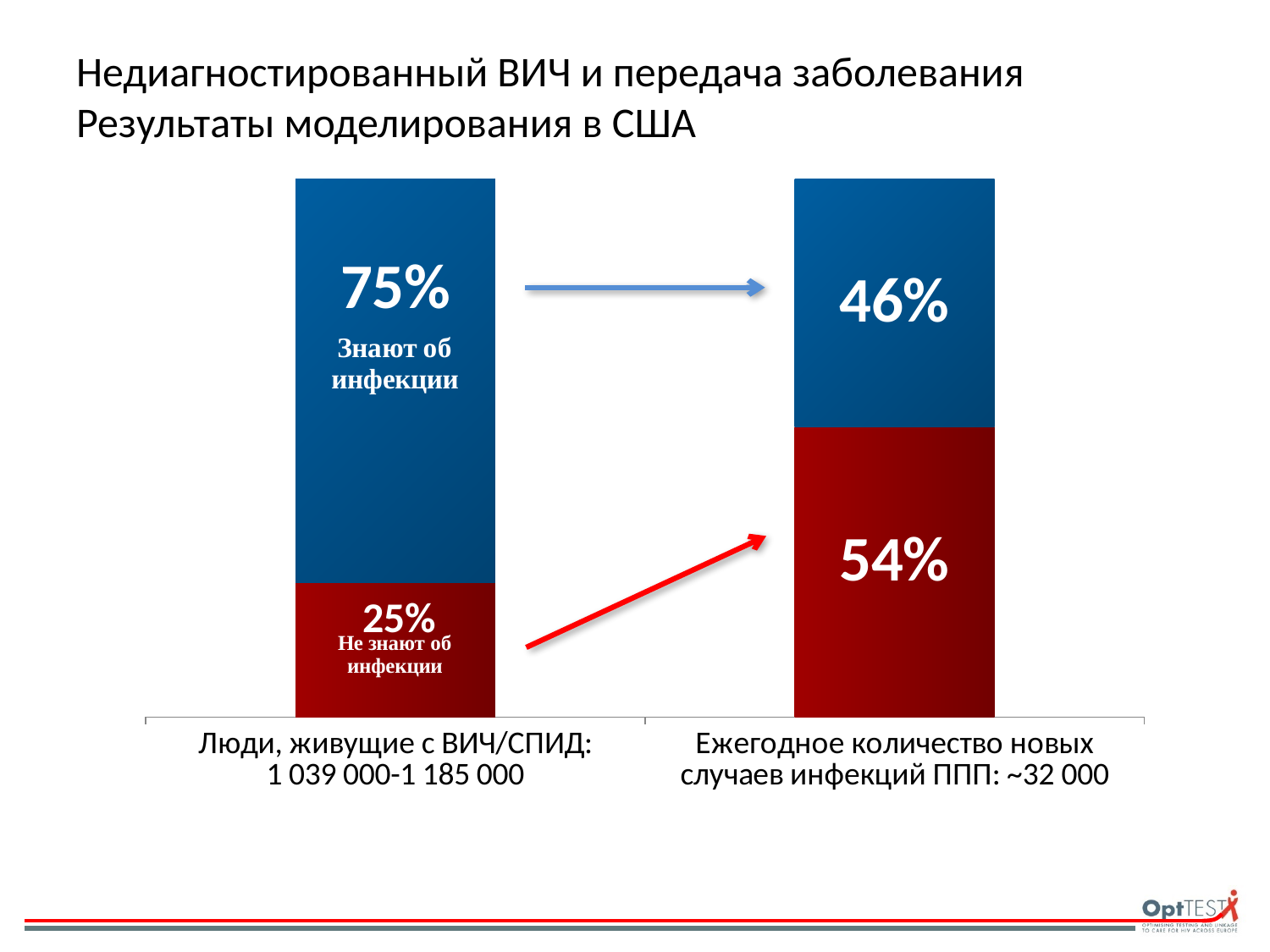
Which is larger: the red segment in the first bar or the red segment in the second bar? the red segment in the second bar (54%) What share of people living with HIV/AIDS (Люди, живущие с ВИЧ/СПИД) do not know about their infection (Не знают об инфекции)? 25% How many bars (categories) does the chart show? 2 What kind of chart is shown on the slide? stacked bar chart In the bar for annual new infections (Ежегодное количество новых случаев инфекций ППП), what percentage is shown in the red segment? 54% In the bar for annual new infections (Ежегодное количество новых случаев инфекций ППП), what percentage is shown in the blue segment? 46% Which colour represents people who do not know about their infection (Не знают об инфекции)? red What is the difference between the red segment of the second bar (54%) and the red segment of the first bar (25%)? 29% What share of people living with HIV/AIDS (Люди, живущие с ВИЧ/СПИД) know about their infection (Знают об инфекции)? 75% What is the total of the two segments in the bar for people living with HIV/AIDS? 100% What is the difference between the blue segment of the first bar (75%) and the blue segment of the second bar (46%)? 29% What approximate annual number of new infections is given in the label of the second bar? ~32 000